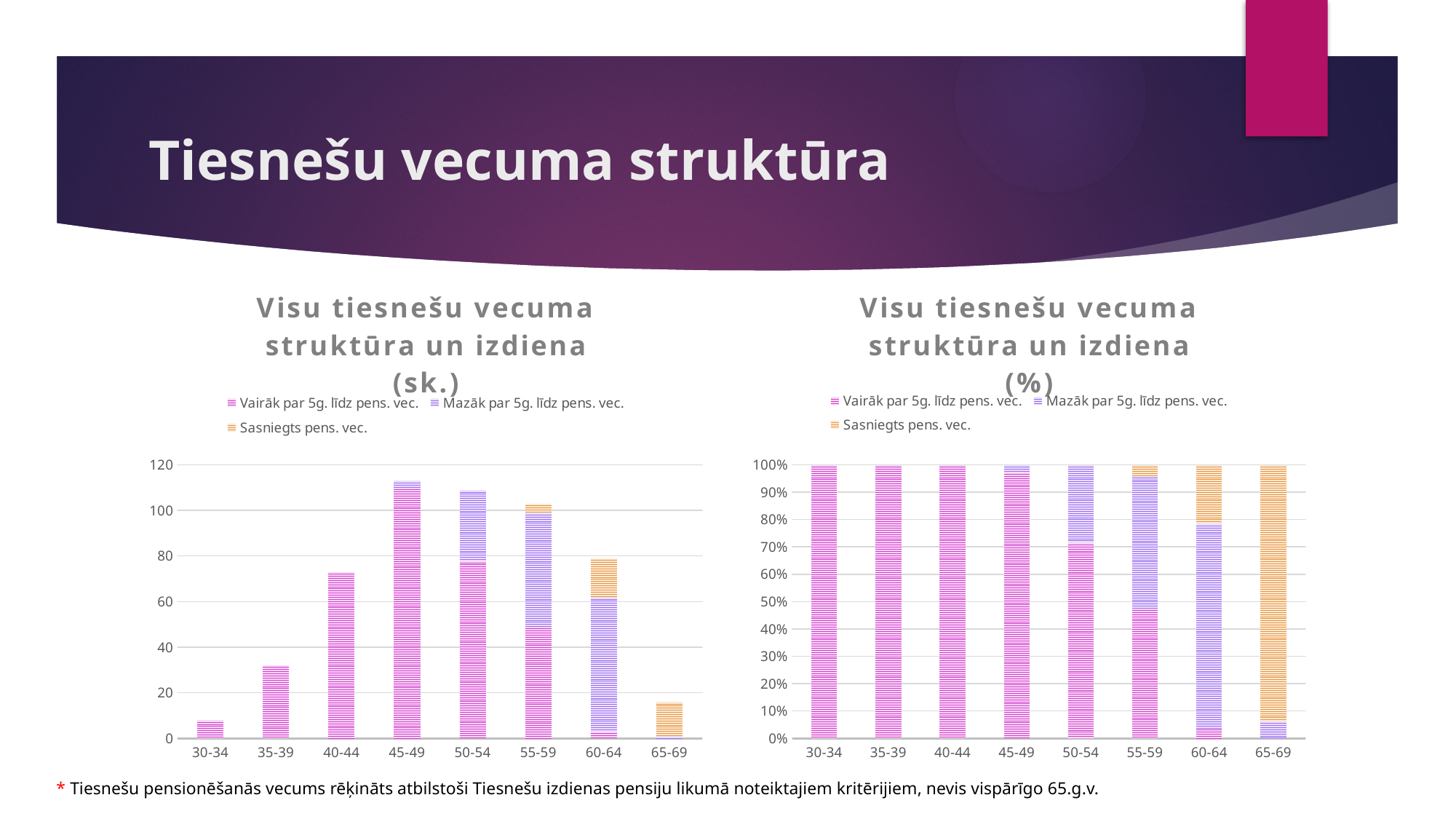
What is the title of the right chart? Visu tiesnešu vecuma struktūra un izdiena (%) In the left chart (sk.), is the total bar for 35-39 greater or less than 40? less In the left chart (sk.), which total bar is larger: 40-44 or 60-64? 60-64 In the left chart (sk.), which age group has the lowest total bar? 30-34 In the right chart (%), is the share of "Sasniegts pens. vec." for 65-69 greater or less than 90%? greater In the right chart (%), is the share of "Vairāk par 5g. līdz pens. vec." for 50-54 greater or less than 60%? greater What kind of chart is the left chart, "Visu tiesnešu vecuma struktūra un izdiena (sk.)"? bar chart How many series does the legend of the right chart, "Visu tiesnešu vecuma struktūra un izdiena (%)", list? 3 How many age-group categories are shown on the x axis of the left chart? 8